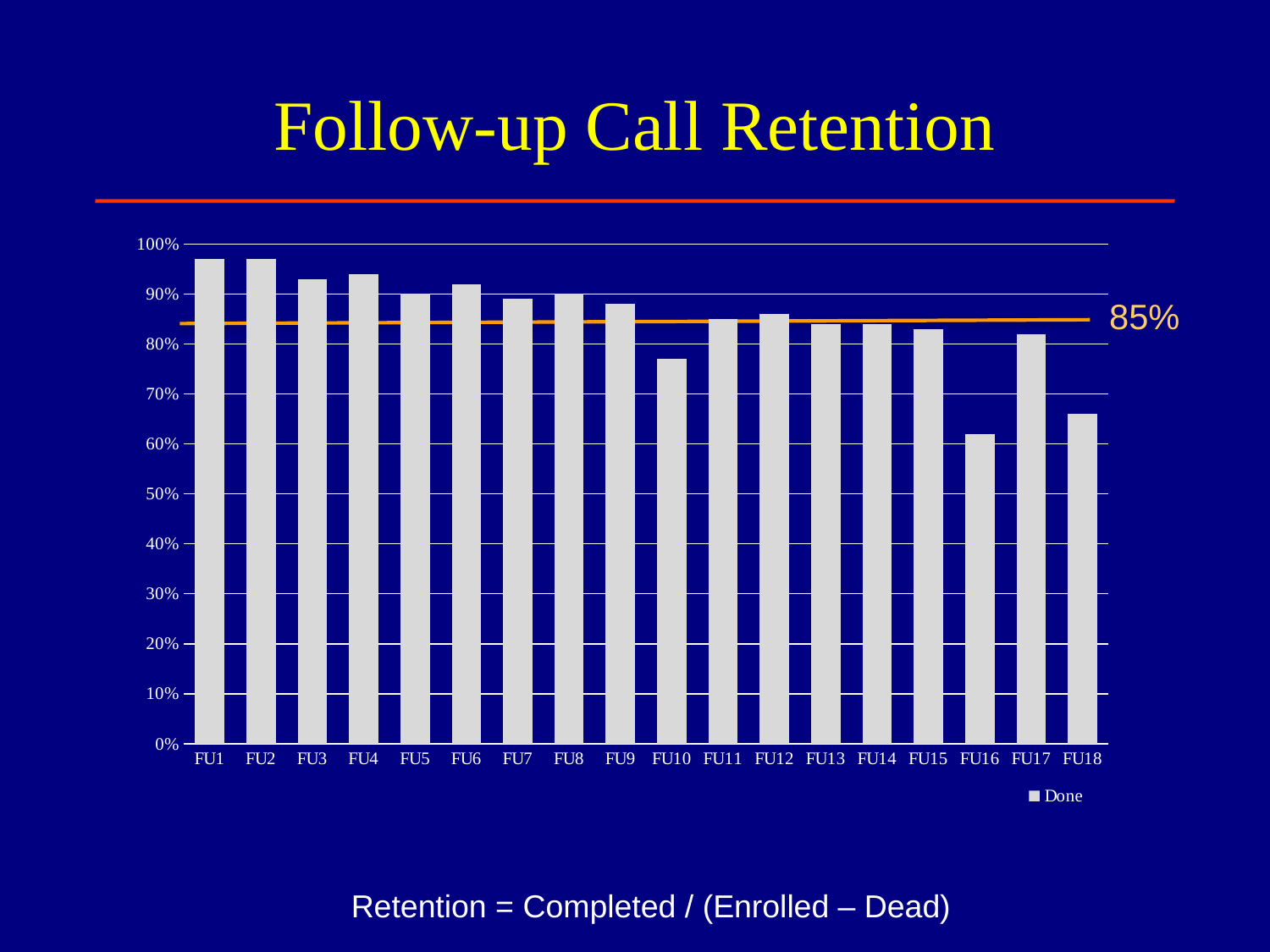
What percentage is labelled on the horizontal reference line drawn across the chart? 85% How many series does the legend list? 1 Do the retention values generally rise or fall from FU1 to FU18? fall Is the value for FU1 greater or less than 90%? greater Is the value for FU10 greater or less than 80%? less How many follow-up call categories are plotted along the x axis? 18 Which follow-up call has the lowest retention? FU16 What is the name of the series shown in the legend? Done Is the value for FU18 greater or less than 60%? greater Which is larger, the value for FU10 or the value for FU11? FU11 What kind of chart is shown on the slide? bar chart